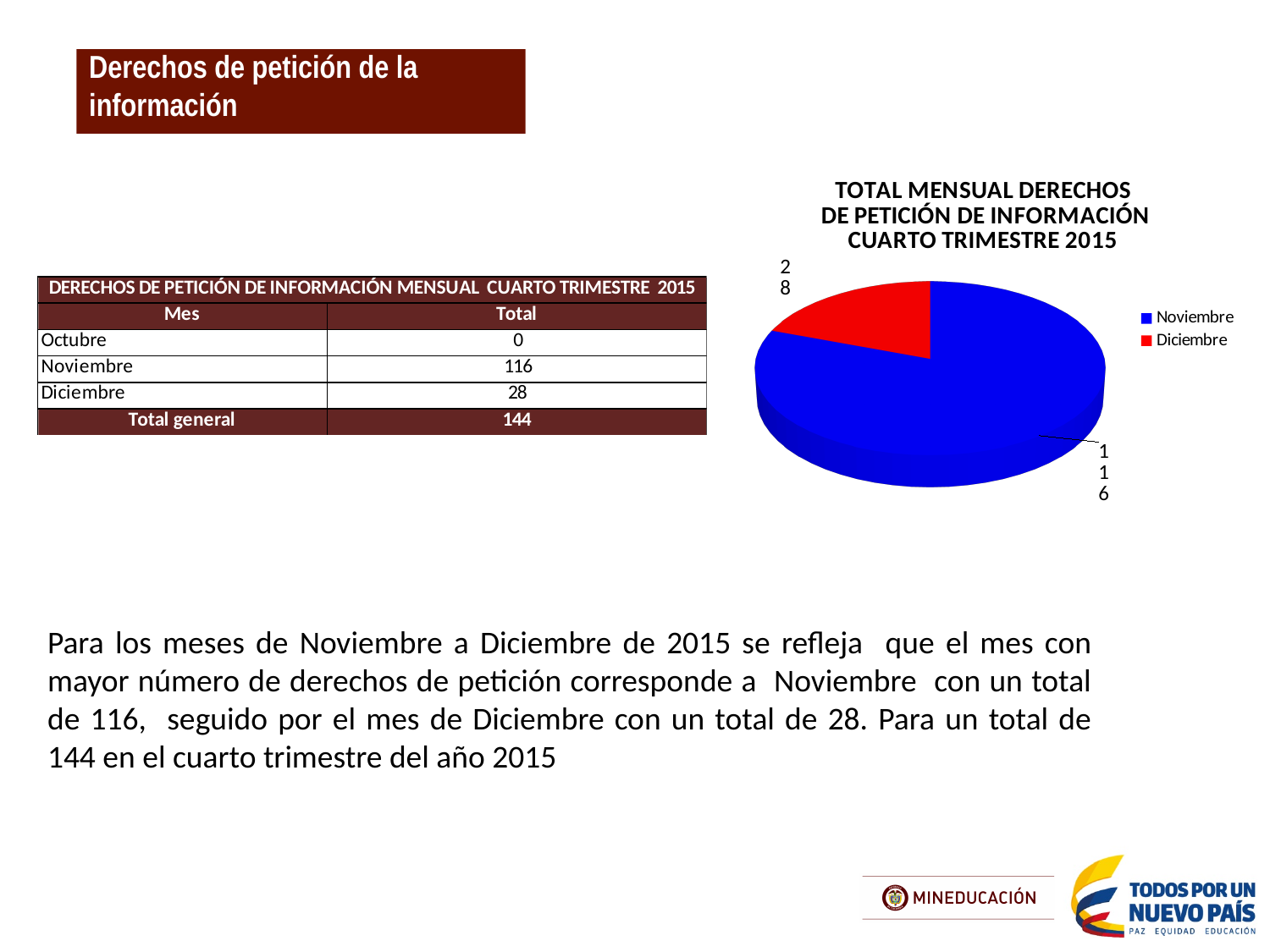
Which month has the largest slice in the pie chart? Noviembre What colour is the Diciembre slice in the pie chart? red What is the value for Noviembre in the pie chart? 116 What is the total of the two values shown in the pie chart? 144 What is the title of the pie chart? TOTAL MENSUAL DERECHOS DE PETICIÓN DE INFORMACIÓN CUARTO TRIMESTRE 2015 Which month has the smallest slice in the pie chart? Diciembre What is the difference between the values for Noviembre and Diciembre in the pie chart? 88 How many entries does the legend of the pie chart list? 2 Which is larger in the pie chart, Noviembre or Diciembre? Noviembre How many slices does the pie chart have? 2 What is the value for Diciembre in the pie chart? 28 What kind of chart is shown on the slide? pie chart